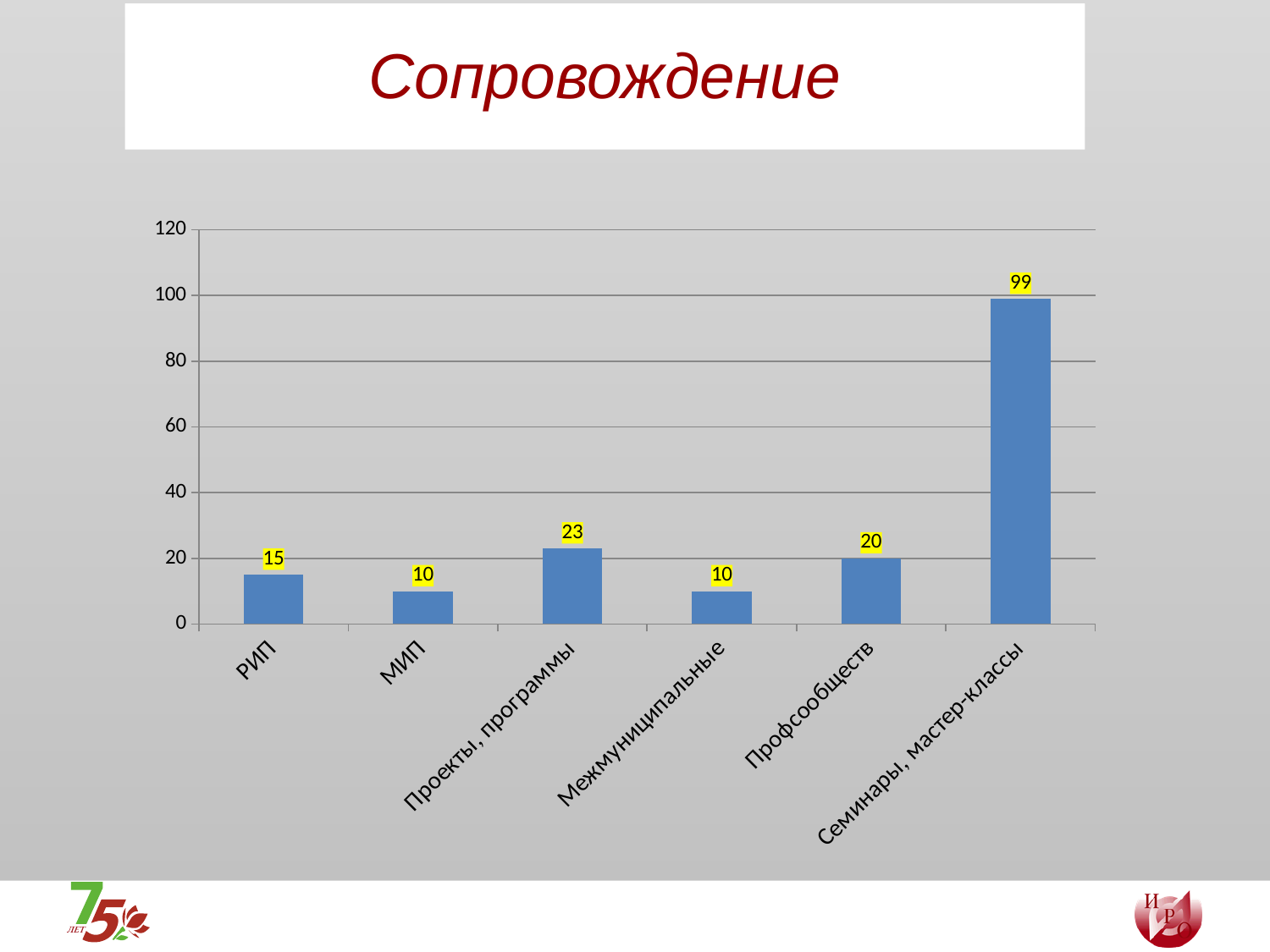
What kind of chart is shown on the slide? bar chart Which category has the highest value? Семинары, мастер-классы What is the value for РИП? 15 What is the difference between the values for Профсообществ and МИП? 10 What is the difference between the values for Семинары, мастер-классы and Проекты, программы? 76 How many categories are shown on the x axis? 6 What is the value for Проекты, программы? 23 Which is larger, the value for РИП or the value for Межмуниципальные? РИП Is the value for Семинары, мастер-классы greater or less than 80? greater What is the value for Профсообществ? 20 What is the title of the slide? Сопровождение What is the value for Семинары, мастер-классы? 99